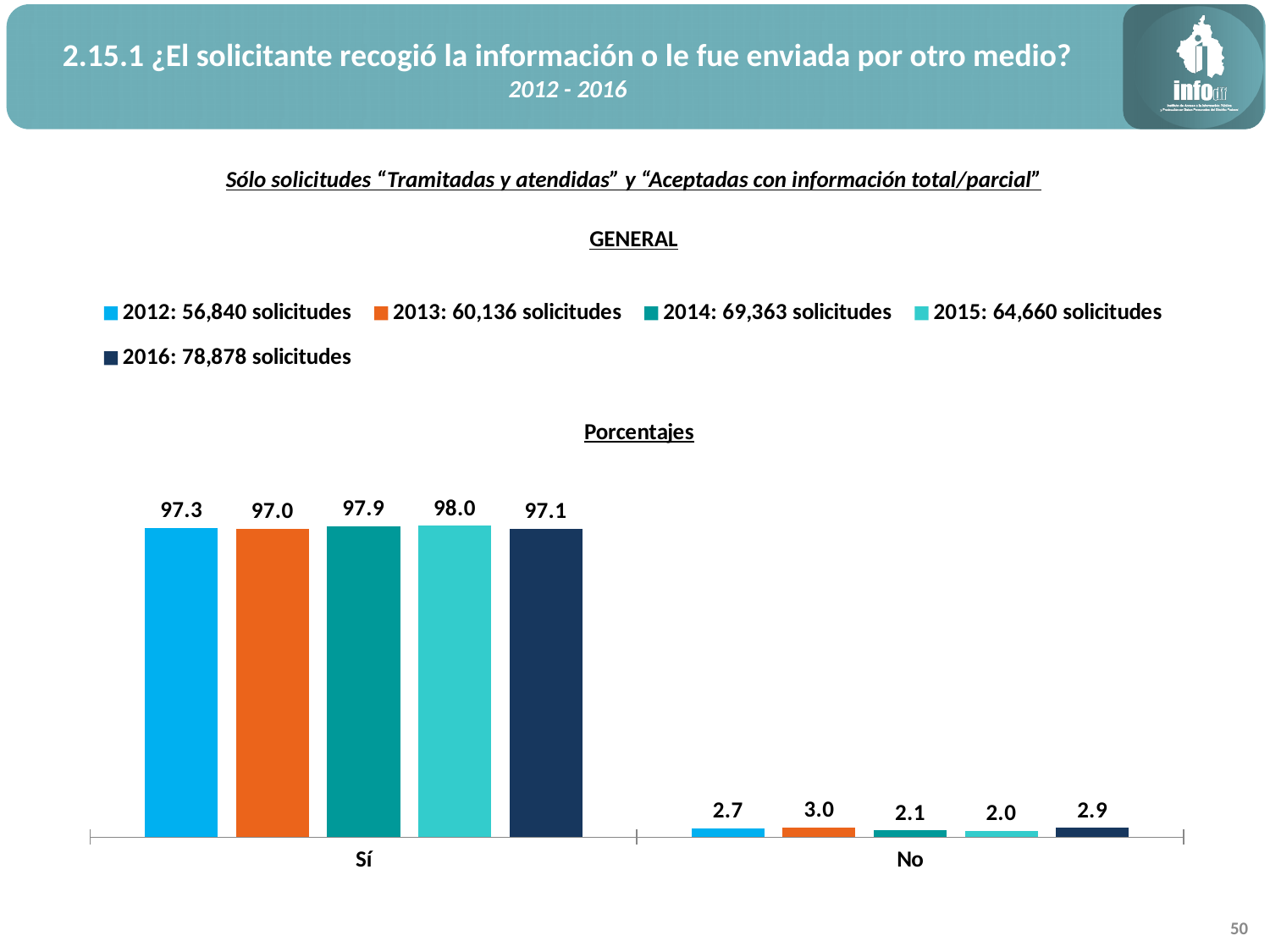
How many series does the legend list? 5 What is the value for 2013 in the "No" category? 3.0 According to the legend, how many solicitudes were there in 2016? 78,878 solicitudes What is the difference between the 2013 and 2014 values in the "No" category? 0.9 Which is larger in the "Sí" category: the value for 2012 or the value for 2013? 2012 Which year has the highest value in the "Sí" category? 2015 What is the difference between the "Sí" and "No" values for 2012? 94.6 Which year has the lowest value in the "No" category? 2015 What kind of chart is shown on the slide? bar chart What is the value for 2016 in the "Sí" category? 97.1 How many categories are shown on the x axis? 2 What is the value for 2015 in the "Sí" category? 98.0